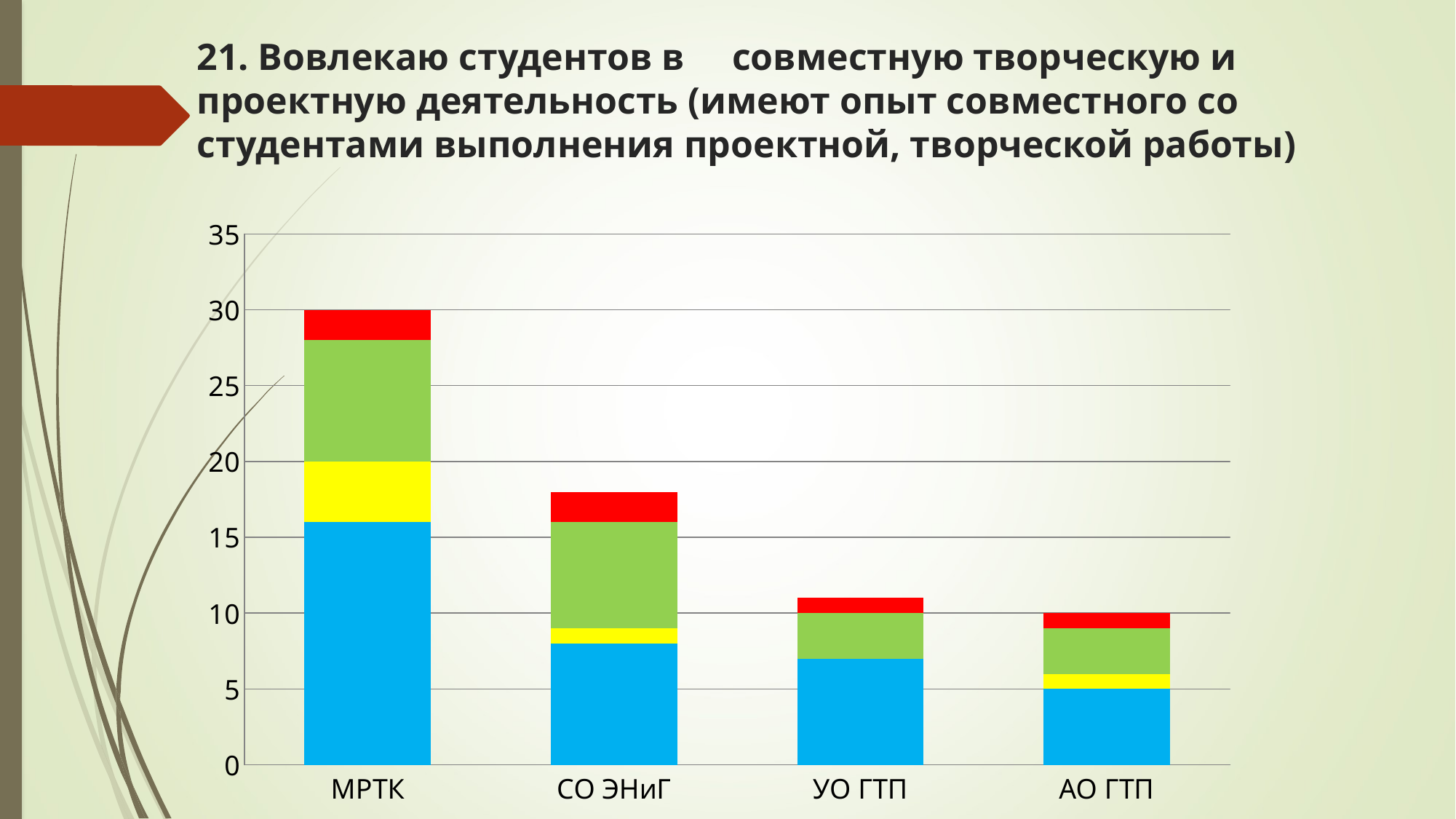
Is the total value for СО ЭНиГ greater or less than 15? greater What is the total height of the stacked bar for АО ГТП? 10 What is the difference between the total for МРТК and the total for АО ГТП? 20 Which category has the tallest stacked bar? МРТК How many categories are shown on the x axis of the chart? 4 What kind of chart is shown on the slide? stacked bar chart Is the total value for СО ЭНиГ greater or less than 20? less Which has the larger total, МРТК or СО ЭНиГ? МРТК What colour is the bottom segment of each stacked bar? blue Which category has the shortest stacked bar? АО ГТП What is the total height of the stacked bar for МРТК? 30 Is the total value for УО ГТП greater or less than 10? greater